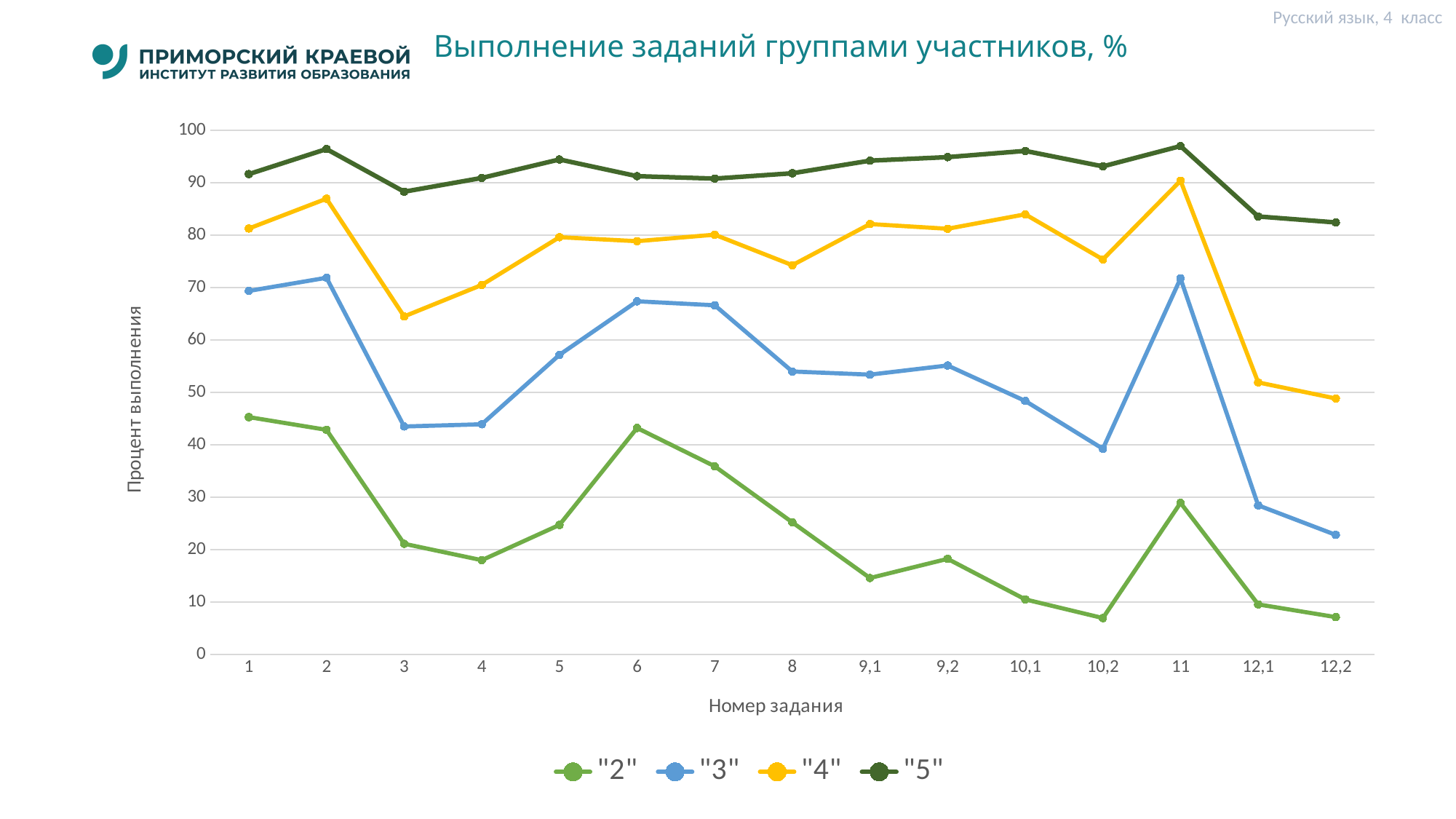
How many series does the legend list? 4 How many task numbers are shown along the x axis? 15 For which task number does the series "4" reach its highest value? 11 For series "3", which task has the larger value: task 6 or task 8? task 6 Is the value for series "4" at task 8 greater or less than 80? less Does the series "2" rise or fall from task 6 to task 10,2? fall What is the title of the chart? Выполнение заданий группами участников, % Is the value for series "2" at task 6 greater or less than 40? greater What kind of chart is shown on the slide? line chart Is the value for series "3" at task 3 greater or less than 50? less For which task number does the series "4" have its lowest value? 12,2 For which task number does the series "3" have its lowest value? 12,2